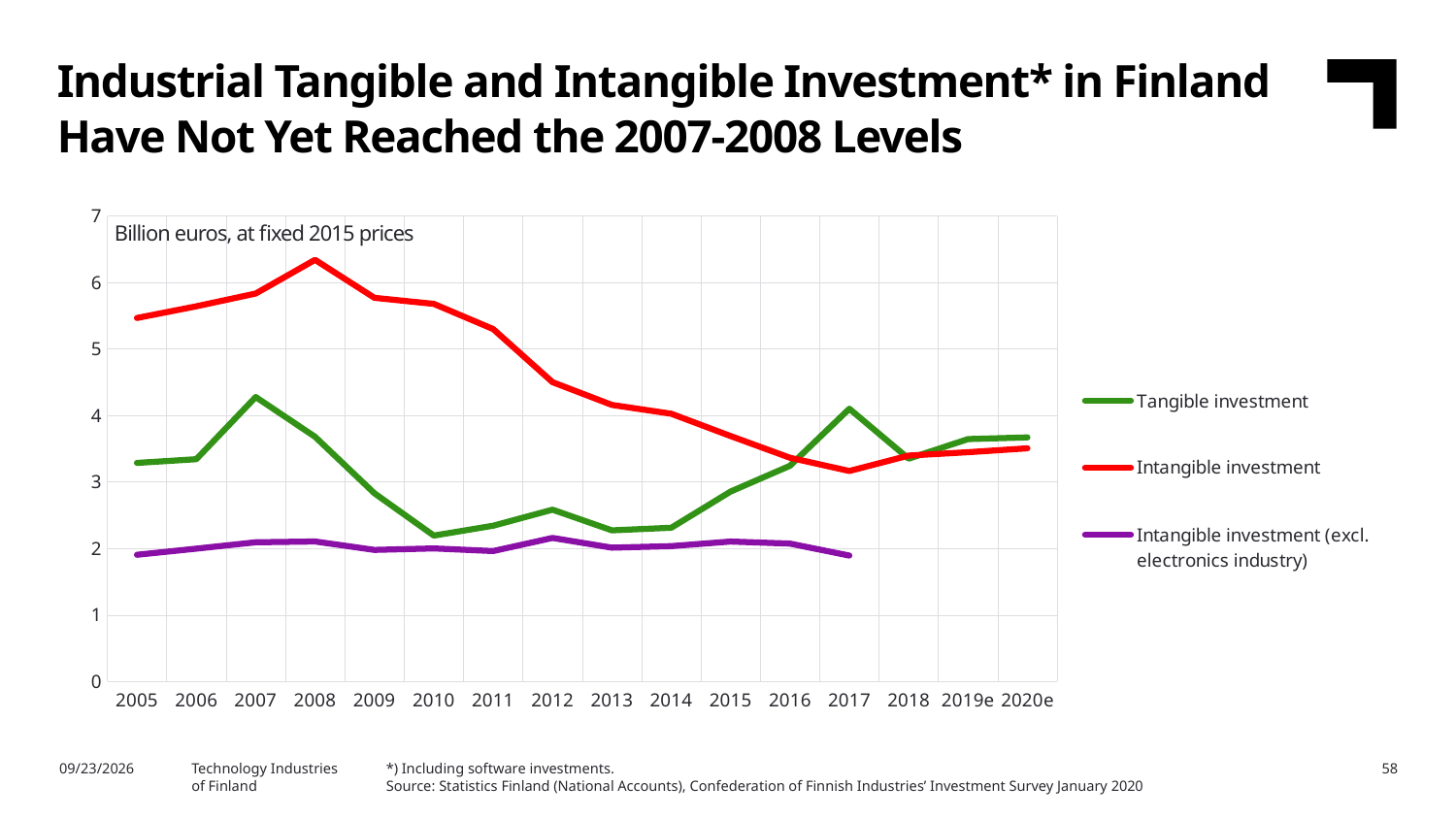
In 2017, which is larger: tangible investment or intangible investment? Tangible investment Is the value for intangible investment in 2008 greater or less than 6? greater Is the value for tangible investment in 2010 greater or less than 3? less How many series does the legend list? 3 In which year does intangible investment reach its highest value? 2008 In which year is intangible investment at its lowest? 2017 Is the value for intangible investment (excl. electronics industry) in 2012 greater or less than 3? less In which year does tangible investment reach its highest value? 2007 What kind of chart is shown on the slide? line chart Does intangible investment rise or fall from 2008 to 2017? fall How many years are shown on the x axis? 16 In 2005, which is larger: tangible investment or intangible investment? Intangible investment